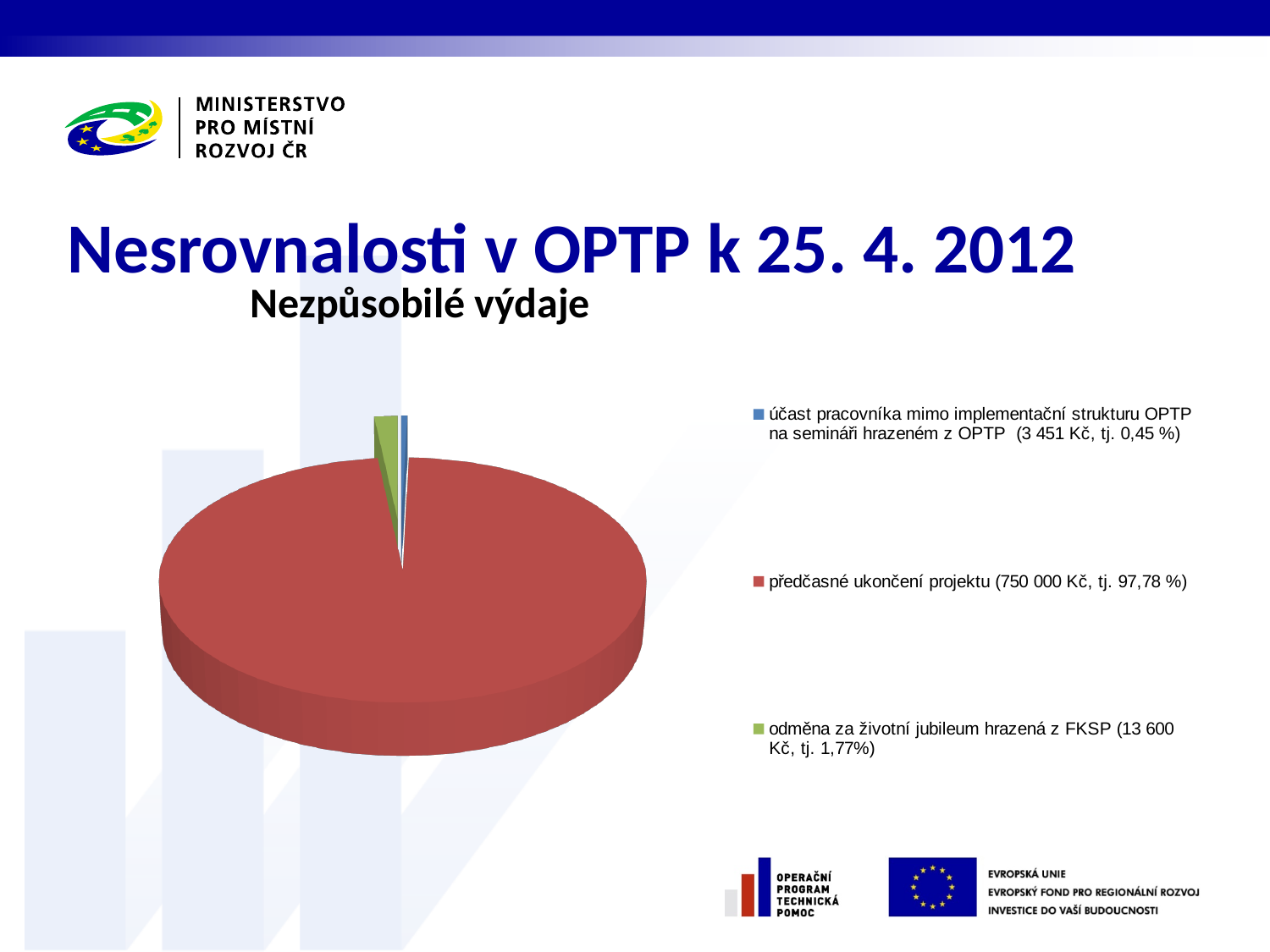
How many slices does the pie chart have? 3 Which category has the largest slice of the pie? předčasné ukončení projektu What is the title of the chart? Nezpůsobilé výdaje Which is larger: the amount for 'odměna za životní jubileum hrazená z FKSP' or for 'účast pracovníka mimo implementační strukturu OPTP na semináři hrazeném z OPTP'? odměna za životní jubileum hrazená z FKSP What share of the pie does 'odměna za životní jubileum hrazená z FKSP' represent? 1,77% What is the difference in Kč between 'předčasné ukončení projektu' and 'odměna za životní jubileum hrazená z FKSP'? 736 400 Kč What colour is the slice for 'předčasné ukončení projektu'? red What kind of chart is shown on the slide? pie chart What share of the pie does 'účast pracovníka mimo implementační strukturu OPTP na semináři hrazeném z OPTP' represent? 0,45 % What amount in Kč is shown for 'předčasné ukončení projektu'? 750 000 Kč What amount in Kč is shown for 'odměna za životní jubileum hrazená z FKSP'? 13 600 Kč Which category has the smallest slice of the pie? účast pracovníka mimo implementační strukturu OPTP na semináři hrazeném z OPTP